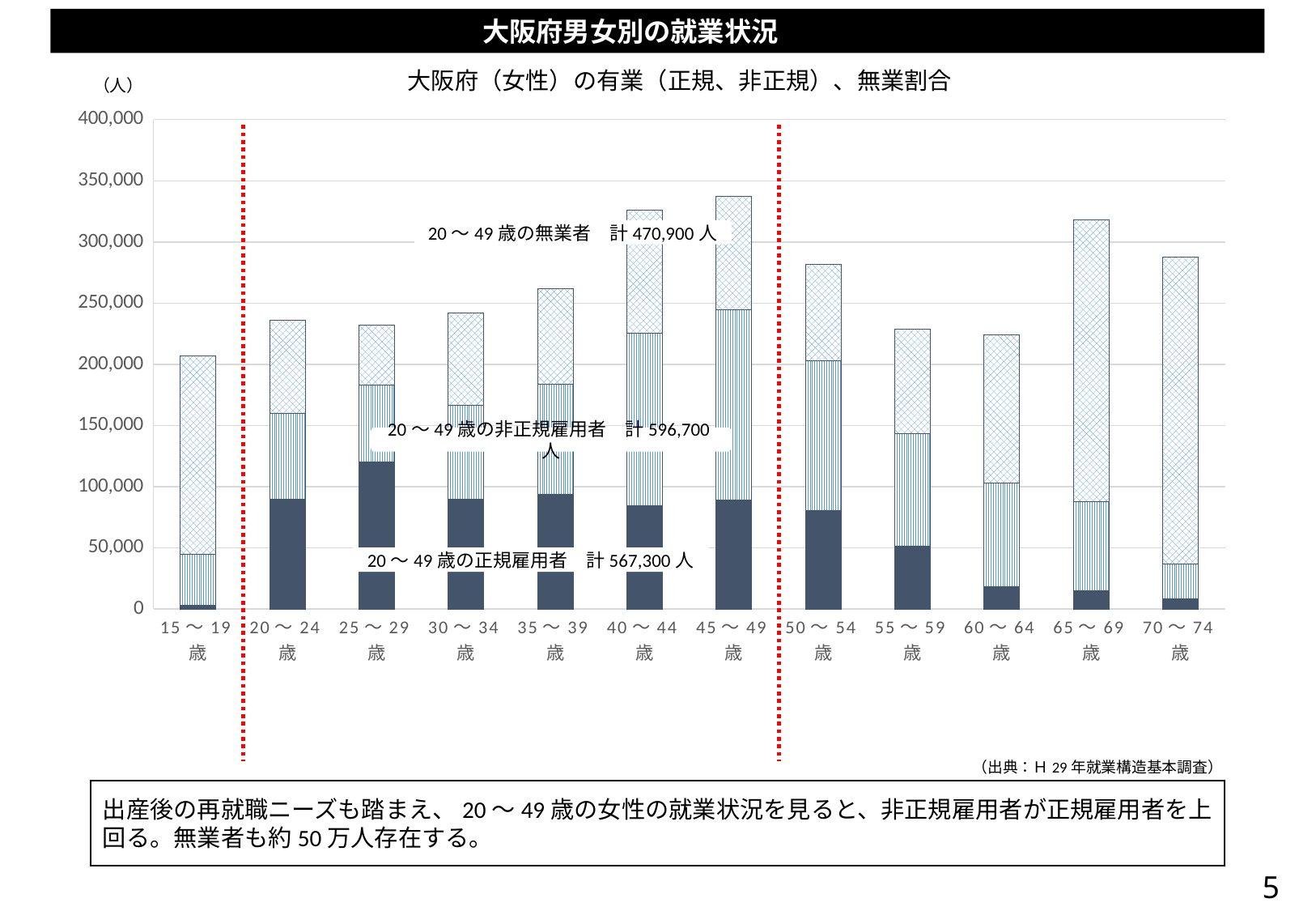
What is the title of the chart? 大阪府（女性）の有業（正規、非正規）、無業割合 Which age group has the tallest stacked bar overall? 45～49歳 What kind of chart is shown on the slide? Stacked bar chart Is the total bar height for the 55～59歳 group greater or less than 250,000? less According to the annotation on the chart, what is the total number of regular employees aged 20 to 49? 567,300人 According to the annotation on the chart, what is the total number of unemployed women aged 20 to 49? 470,900人 How many age-group categories are shown on the x axis? 12 Which age group has the shortest stacked bar overall? 15～19歳 According to the annotation on the chart, what is the total number of non-regular employees aged 20 to 49? 596,700人 Which has a taller total bar, the 45～49歳 group or the 50～54歳 group? 45～49歳 What is the unit shown at the top of the vertical axis? （人） Is the total bar height for the 40～44歳 group greater or less than 300,000? greater